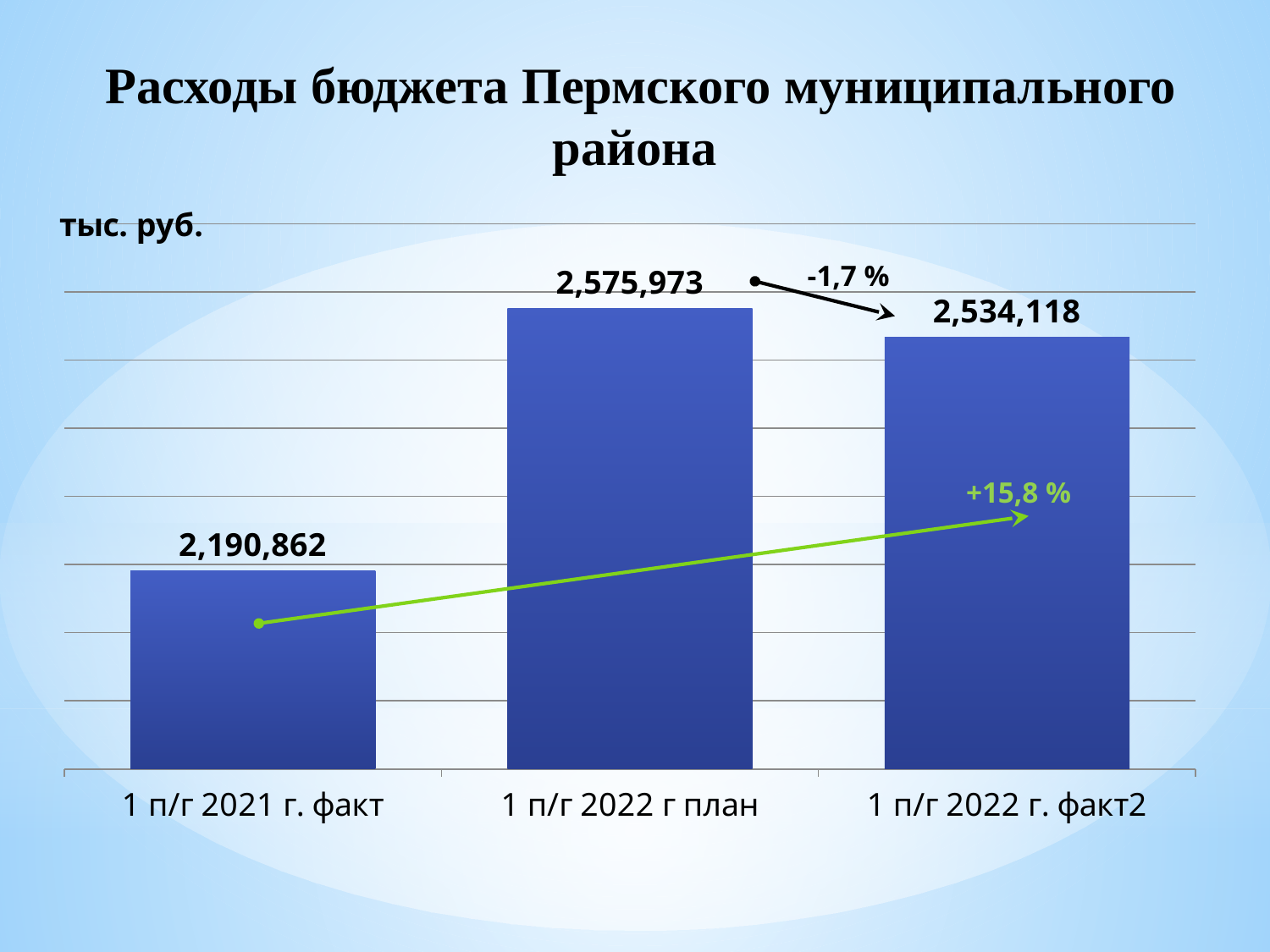
What is the value for "1 п/г 2022 г план"? 2,575,973 What kind of chart is shown on the slide? Bar chart What is the difference between the values for "1 п/г 2022 г план" and "1 п/г 2022 г. факт2"? 41,855 What is the value for "1 п/г 2022 г. факт2"? 2,534,118 Which category has the lowest value? 1 п/г 2021 г. факт What is the difference between the values for "1 п/г 2022 г. факт2" and "1 п/г 2021 г. факт"? 343,256 What percentage change is annotated between "1 п/г 2022 г план" and "1 п/г 2022 г. факт2"? -1,7 % Which category has the highest value? 1 п/г 2022 г план What unit of measurement is indicated for the chart values? тыс. руб. What is the value for "1 п/г 2021 г. факт"? 2,190,862 Which is larger, the value for "1 п/г 2022 г план" or the value for "1 п/г 2022 г. факт2"? 1 п/г 2022 г план How many categories are shown in the chart? 3